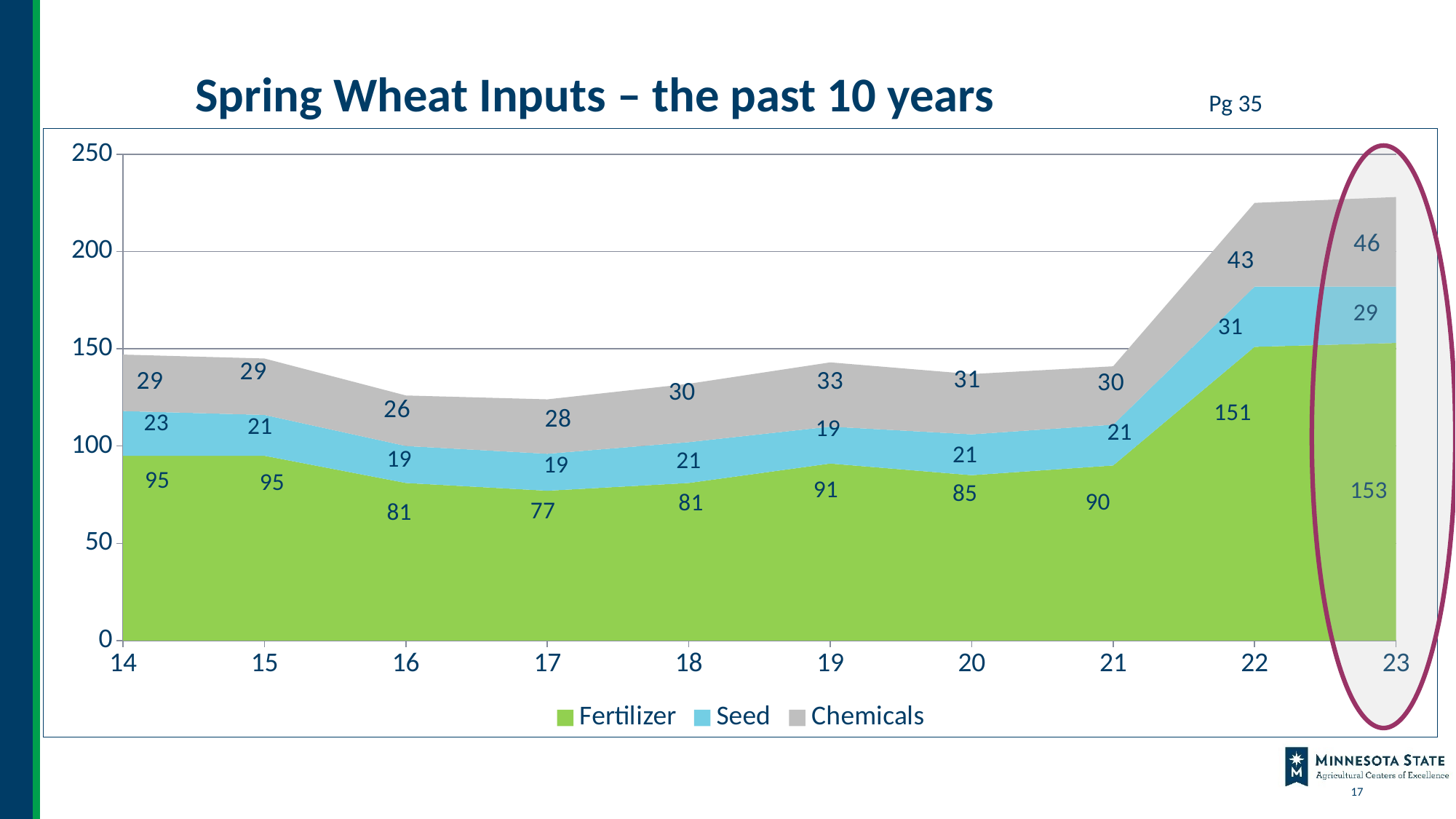
What is the Fertilizer value for year 23? 153 What kind of chart is shown on the slide? Stacked area chart What is the Chemicals value for year 19? 33 In which year is the Chemicals value highest? 23 What is the Seed value for year 14? 23 Which is larger, the Seed value for year 22 or the Seed value for year 23? Year 22 In which year is the Fertilizer value lowest? 17 Which series is shown in green in the legend? Fertilizer How many series does the legend list? 3 How many years are shown on the x axis? 10 What is the difference between the Fertilizer values for year 22 and year 21? 61 What is the total of Fertilizer, Seed and Chemicals for year 23? 228